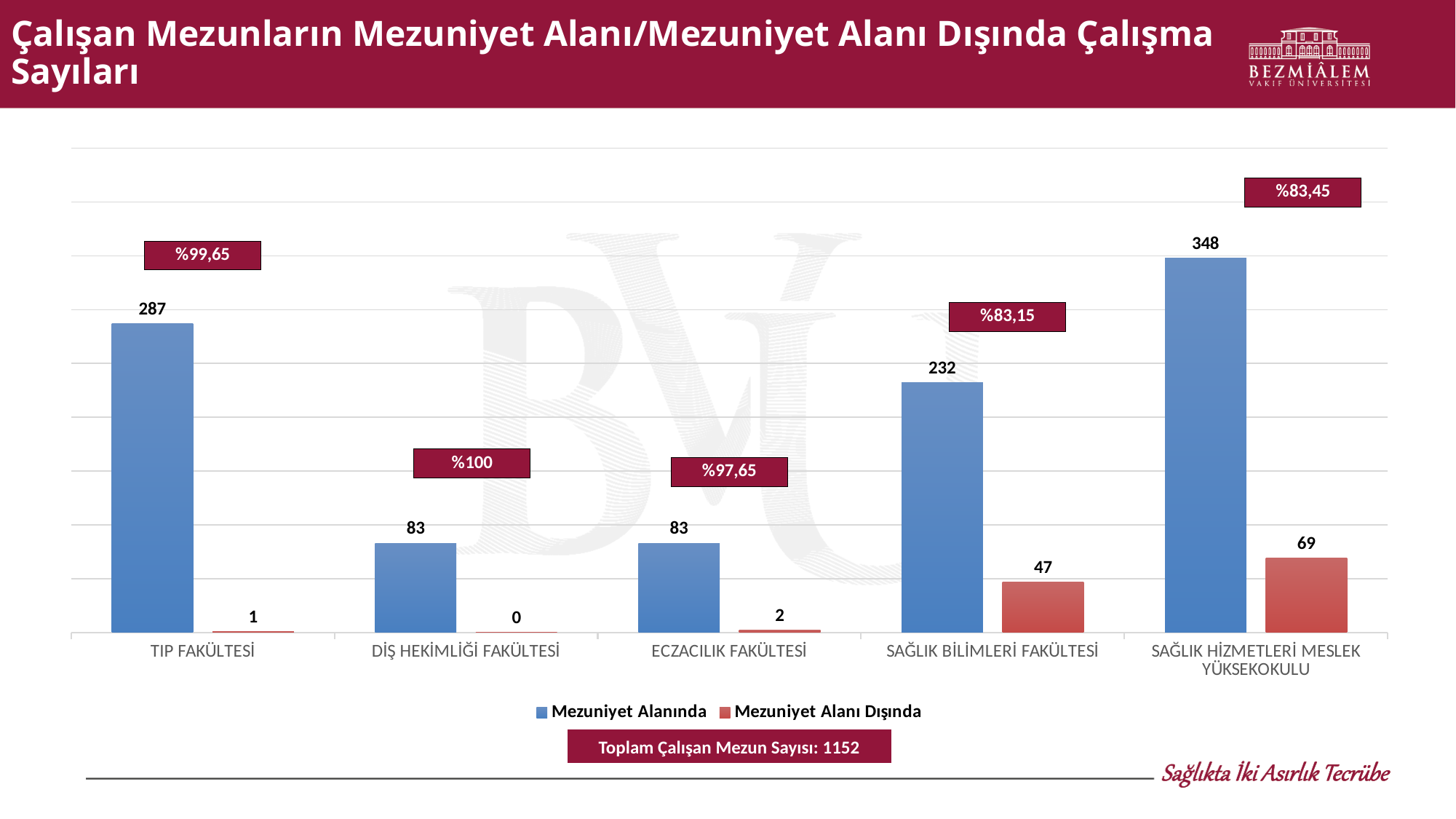
What is the value of Mezuniyet Alanı Dışında for ECZACILIK FAKÜLTESİ? 2 How many categories are shown on the x axis? 5 Which category has the lowest Mezuniyet Alanı Dışında value? DİŞ HEKİMLİĞİ FAKÜLTESİ What is the value of Mezuniyet Alanında for TIP FAKÜLTESİ? 287 What is the difference between the Mezuniyet Alanında values for SAĞLIK HİZMETLERİ MESLEK YÜKSEKOKULU and SAĞLIK BİLİMLERİ FAKÜLTESİ? 116 How many series does the legend list? 2 Which category has the highest Mezuniyet Alanında value? SAĞLIK HİZMETLERİ MESLEK YÜKSEKOKULU What total number of working graduates (Toplam Çalışan Mezun Sayısı) is shown below the chart? 1152 Which is larger: the Mezuniyet Alanı Dışında value for SAĞLIK HİZMETLERİ MESLEK YÜKSEKOKULU or for SAĞLIK BİLİMLERİ FAKÜLTESİ? SAĞLIK HİZMETLERİ MESLEK YÜKSEKOKULU What is the value of Mezuniyet Alanı Dışında for SAĞLIK BİLİMLERİ FAKÜLTESİ? 47 What percentage label is shown above SAĞLIK HİZMETLERİ MESLEK YÜKSEKOKULU? %83,45 What kind of chart is shown on the slide? bar chart